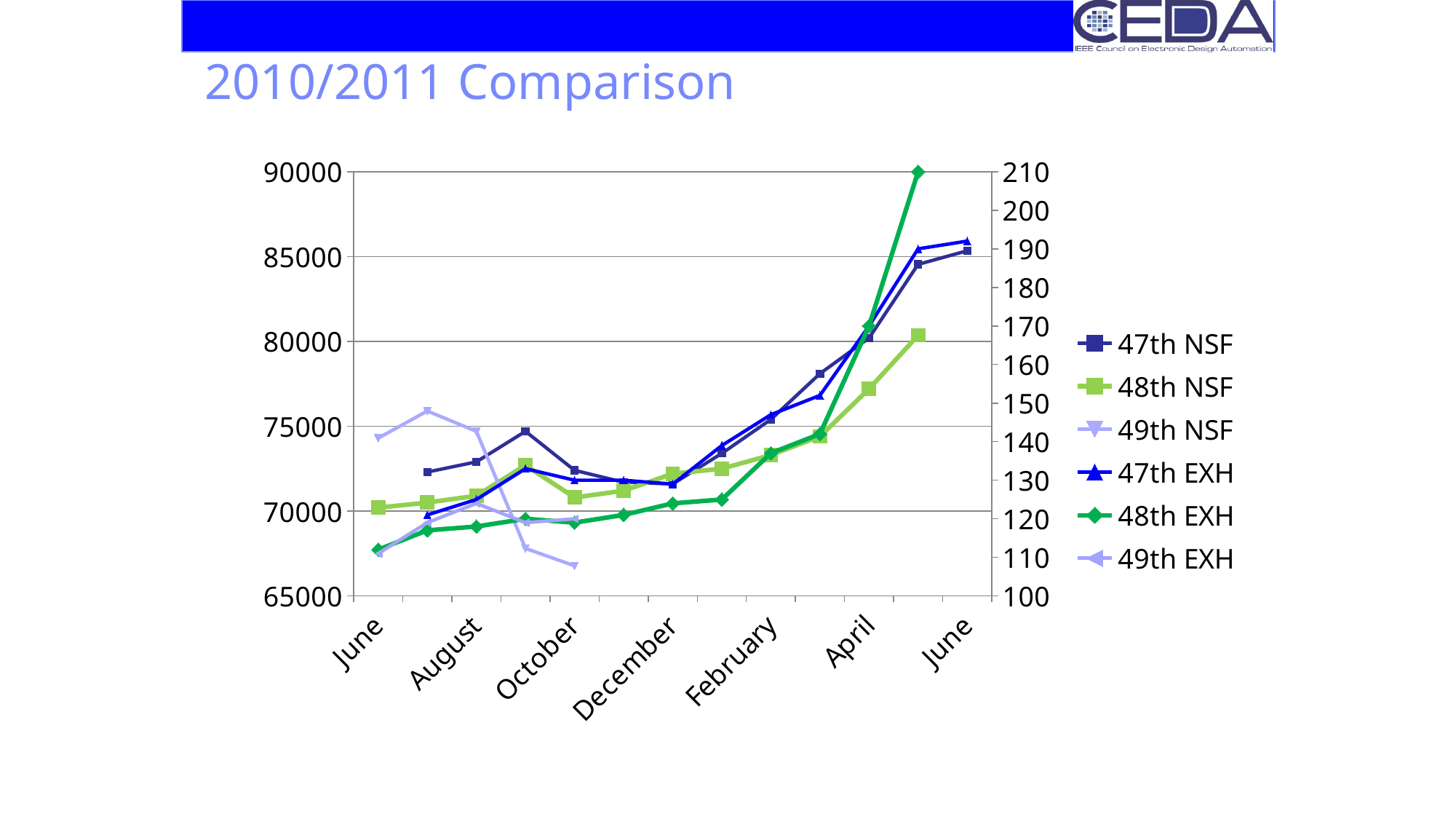
At the final plotted point of each, which line is plotted higher on the chart, 48th EXH or 48th NSF? 48th EXH Is the first plotted point of the 47th NSF line (in July) above or below the 70000 gridline? above Which series reaches the highest point on the chart? 48th EXH Is the highest point of the 48th EXH line above or below the 85000 gridline? above What is the title of the slide containing the chart? 2010/2011 Comparison What type of chart is shown on the slide? line chart How many month labels are shown along the x axis? 7 Does the 48th EXH line rise or fall from December to its final point? rise How many series does the legend list? 6 Does the 49th NSF line rise or fall from August to October? fall Is the last plotted point of the 49th EXH line (in October) above or below the 70000 gridline? below Which series is drawn in green with diamond markers? 48th EXH